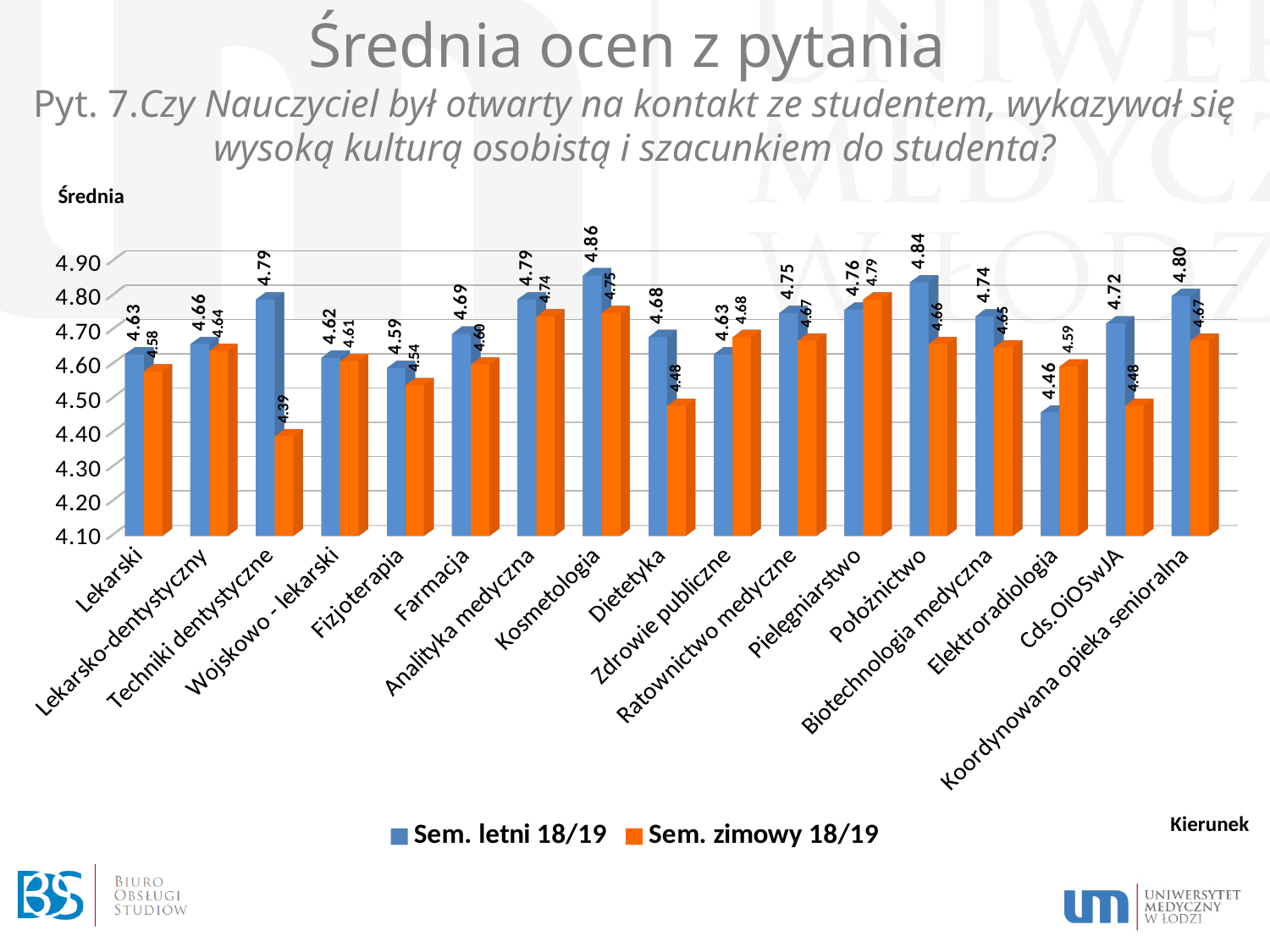
Which category has the lowest value in the Sem. letni 18/19 series? Elektroradiologia What is the value for Techniki dentystyczne in the Sem. zimowy 18/19 series? 4.39 Which category has the highest value in the Sem. letni 18/19 series? Kosmetologia What is the value for Elektroradiologia in the Sem. letni 18/19 series? 4.46 Which category has the lowest value in the Sem. zimowy 18/19 series? Techniki dentystyczne What is the difference between the Sem. letni 18/19 and Sem. zimowy 18/19 values for Techniki dentystyczne? 0.40 What is the value for Kosmetologia in the Sem. letni 18/19 series? 4.86 How many categories (kierunki) are shown on the x axis? 17 Is the Sem. zimowy 18/19 value for Dietetyka greater or less than 4.50? less How many series does the legend list? 2 For Pielęgniarstwo, which series has the larger value: Sem. letni 18/19 or Sem. zimowy 18/19? Sem. zimowy 18/19 What kind of chart is shown on the slide? bar chart